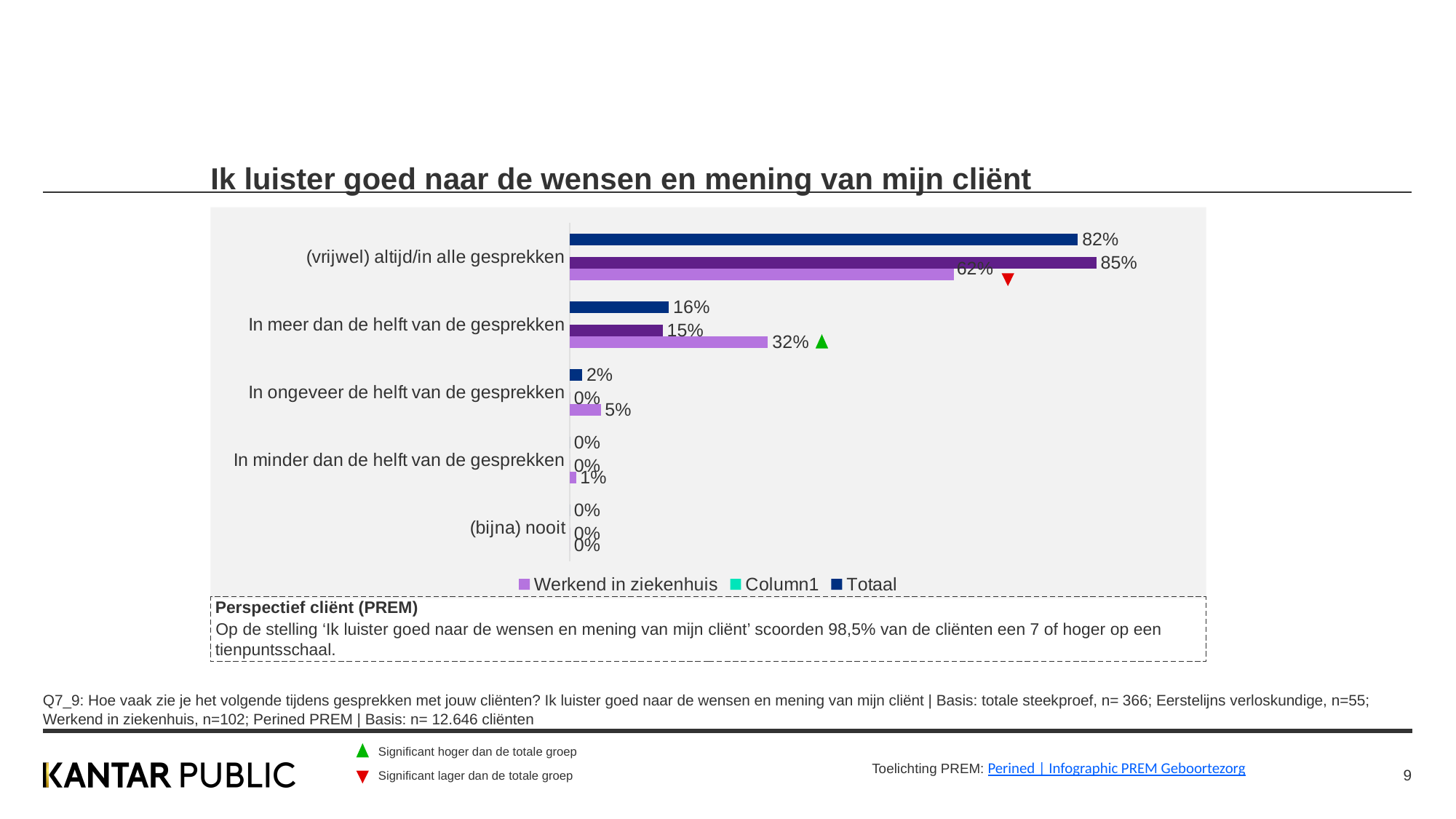
What is the Totaal value for '(vrijwel) altijd/in alle gesprekken'? 82% For 'In meer dan de helft van de gesprekken', which is larger: the Totaal value or the 'Werkend in ziekenhuis' value? Werkend in ziekenhuis What is the title of the chart? Ik luister goed naar de wensen en mening van mijn cliënt What is the 'Werkend in ziekenhuis' value for '(vrijwel) altijd/in alle gesprekken'? 62% What is the 'Werkend in ziekenhuis' value for 'In meer dan de helft van de gesprekken'? 32% What is the 'Werkend in ziekenhuis' value for 'In minder dan de helft van de gesprekken'? 1% What kind of chart is shown on the slide? Bar chart How many categories are shown on the chart? 5 What is the Totaal value for 'In ongeveer de helft van de gesprekken'? 2% What is the difference between the Totaal value and the 'Werkend in ziekenhuis' value for '(vrijwel) altijd/in alle gesprekken'? 20% How many series does the legend list? 3 Which category has the highest Totaal value? (vrijwel) altijd/in alle gesprekken